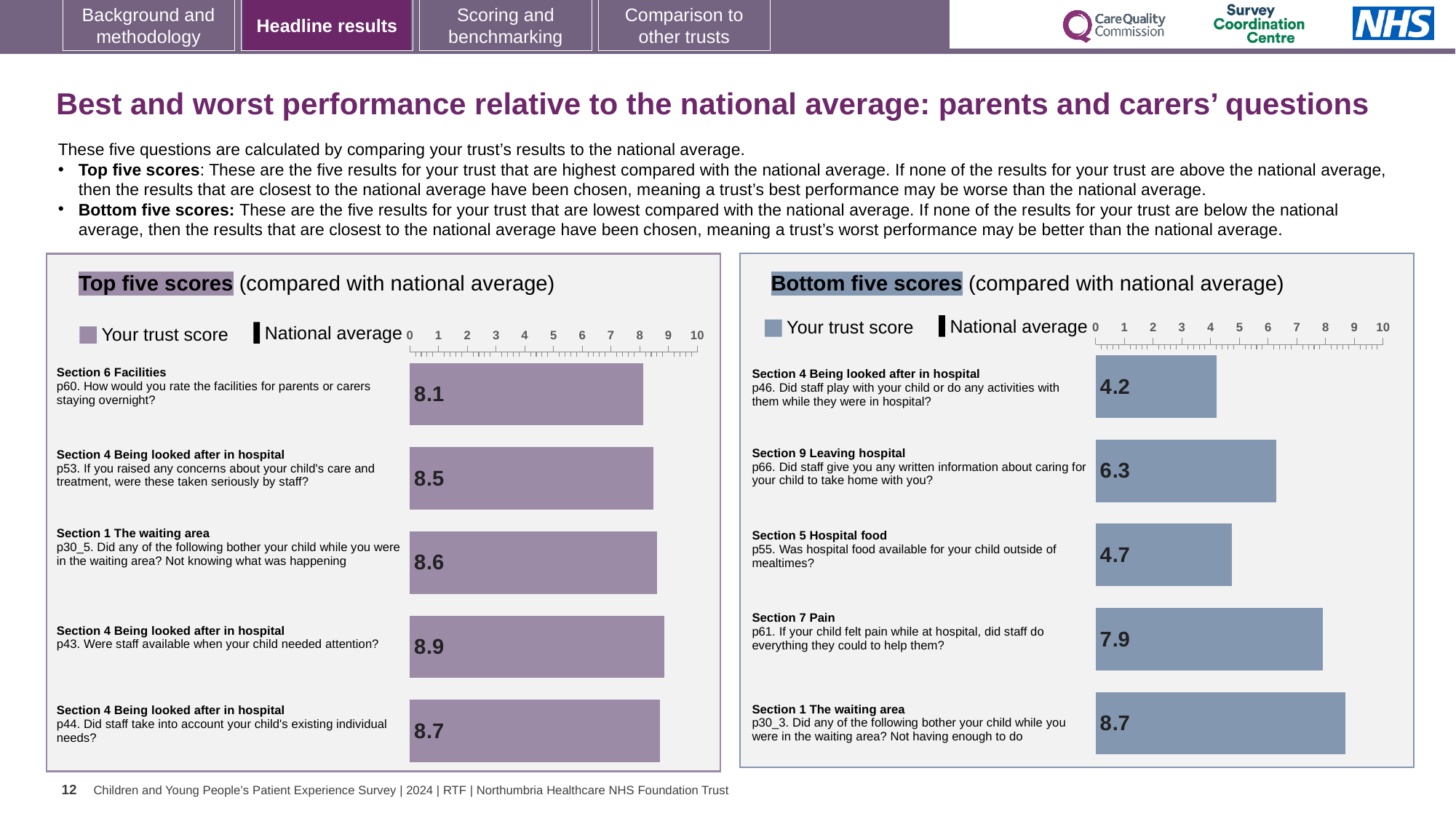
In the Bottom five scores chart, what is the difference between the trust scores for p30_3 and p46? 4.5 In the Top five scores chart, which question has the highest trust score? p43. Were staff available when your child needed attention? In the Bottom five scores chart, which has the larger trust score: p55 (hospital food outside of mealtimes) or p66 (written information to take home)? p66 How many questions are shown in the Bottom five scores chart? 5 In the Top five scores chart, what is the trust score for p60 (How would you rate the facilities for parents or carers staying overnight?)? 8.1 In the Bottom five scores chart, which question has the lowest trust score? p46. Did staff play with your child or do any activities with them while they were in hospital? In the Bottom five scores chart, what is the trust score for p66 (Did staff give you any written information about caring for your child to take home with you?)? 6.3 How many series does the legend of the Top five scores chart list? 2 In the Bottom five scores chart, what is the trust score for p61 (If your child felt pain while at hospital, did staff do everything they could to help them?)? 7.9 What type of chart is used in the Top five scores panel? Bar chart In the Top five scores chart, what is the trust score for p43 (Were staff available when your child needed attention?)? 8.9 In the Top five scores chart, what is the difference between the highest trust score (p43) and the lowest trust score (p60)? 0.8